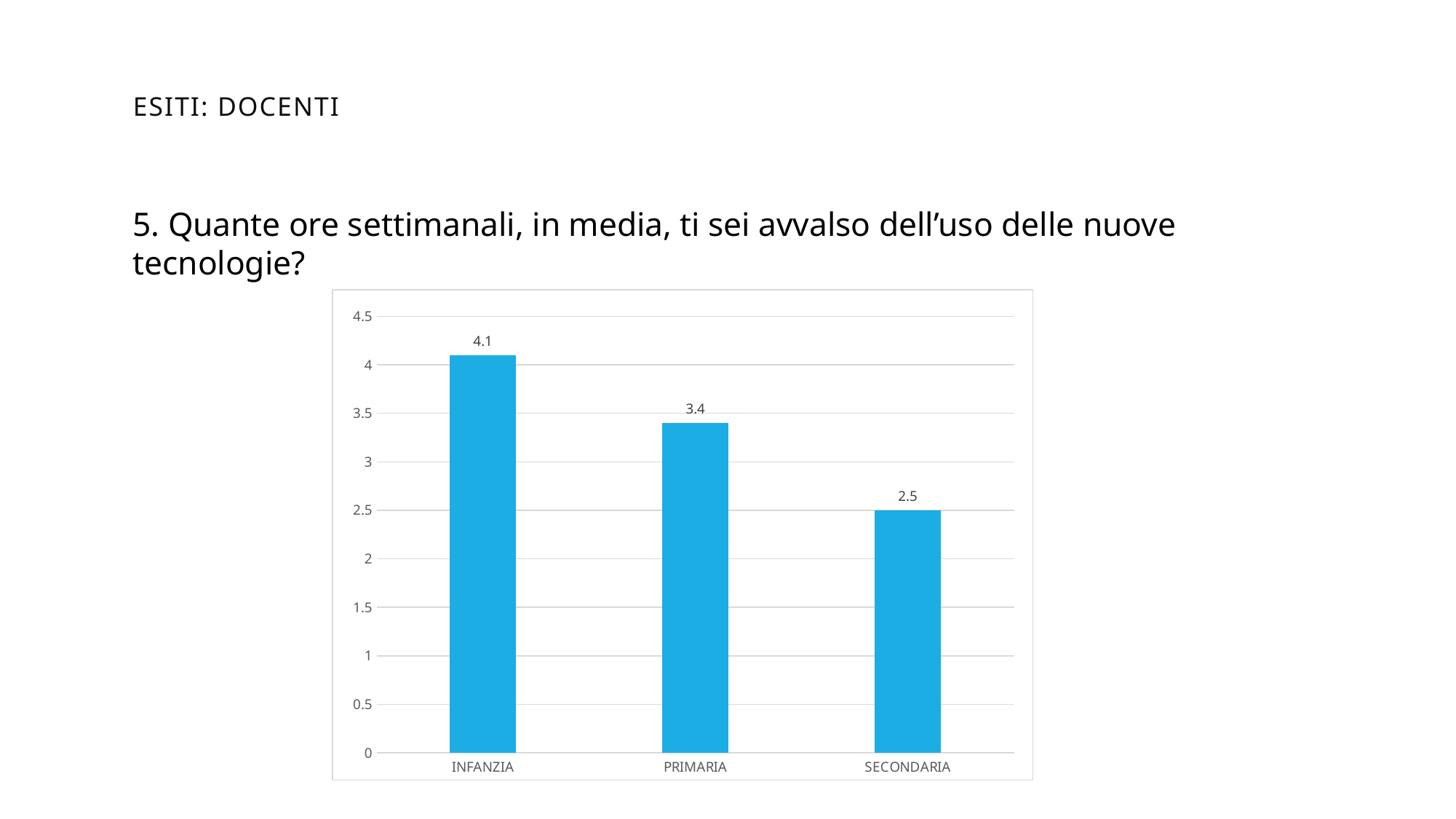
Which is larger, the value for PRIMARIA or the value for SECONDARIA? PRIMARIA What is the value for SECONDARIA? 2.5 What is the value for INFANZIA? 4.1 How many categories are shown on the x axis? 3 What is the difference between the values for INFANZIA and SECONDARIA? 1.6 What is the value for PRIMARIA? 3.4 Do the values rise or fall from INFANZIA to SECONDARIA along the x axis? fall Which category has the lowest value? SECONDARIA What is the difference between the values for PRIMARIA and SECONDARIA? 0.9 Which category has the highest value? INFANZIA Is the value for PRIMARIA greater or less than 3? greater What kind of chart is shown on the slide? bar chart